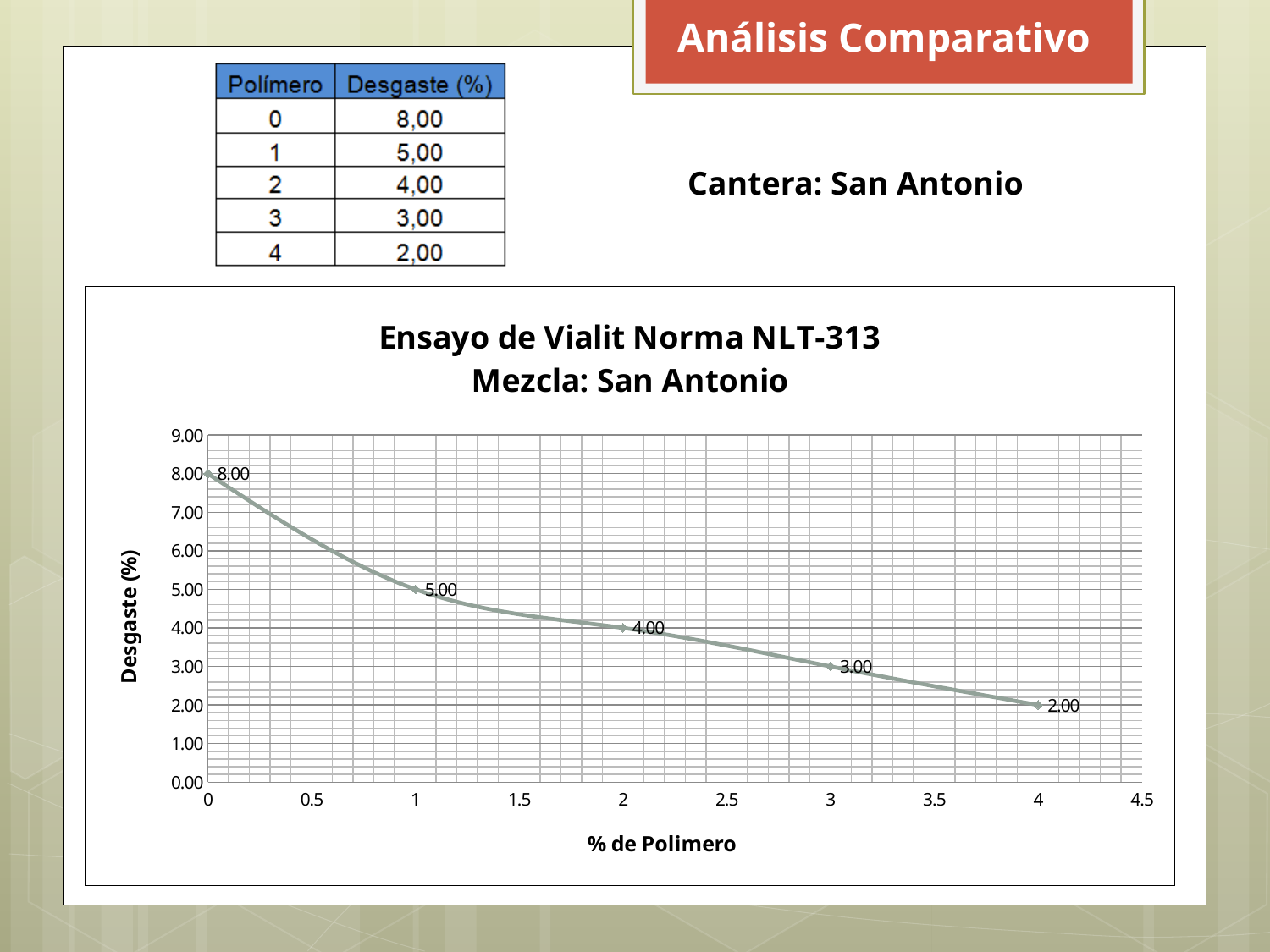
What is the Desgaste (%) value at 4% de Polimero? 2.00 What is the difference in Desgaste (%) between 1% and 4% de Polimero? 3.00 How many data points are plotted on the chart? 5 What type of chart is shown on the slide? Line chart What is the Desgaste (%) value at 0% de Polimero? 8.00 At which % de Polimero is the Desgaste (%) lowest? 4 What is the difference in Desgaste (%) between 0% and 1% de Polimero? 3.00 At which % de Polimero is the Desgaste (%) highest? 0 What is the title of the chart? Ensayo de Vialit Norma NLT-313 Mezcla: San Antonio Does the Desgaste (%) rise or fall as % de Polimero increases? Fall What is the Desgaste (%) value at 2% de Polimero? 4.00 Which has a higher Desgaste (%): 1% de Polimero or 3% de Polimero? 1% de Polimero